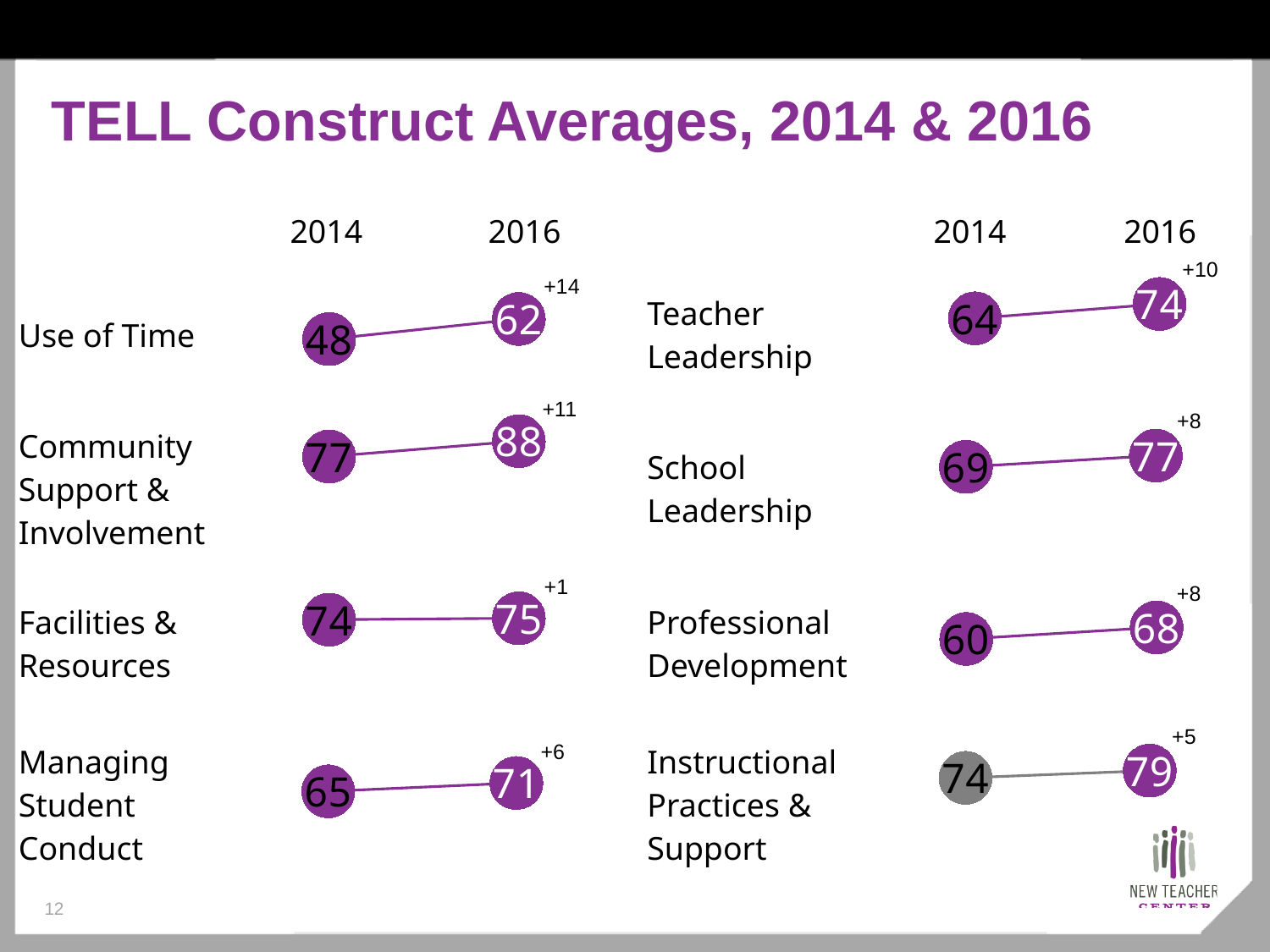
Which construct has the highest 2016 value? Community Support & Involvement What is the difference between the 2016 and 2014 values for Teacher Leadership? 10 What is the 2016 value for Professional Development? 68 Which is larger, the 2016 value for Managing Student Conduct or the 2016 value for Instructional Practices & Support? Instructional Practices & Support Which construct shows the largest increase from 2014 to 2016? Use of Time What is the 2016 value for Community Support & Involvement? 88 Which construct has the lowest 2014 value? Use of Time What is the 2014 value for Use of Time? 48 How many constructs are shown on the slide? 8 Which construct shows the smallest increase from 2014 to 2016? Facilities & Resources Do the values rise or fall from 2014 to 2016 for every construct? rise What is the 2014 value for School Leadership? 69